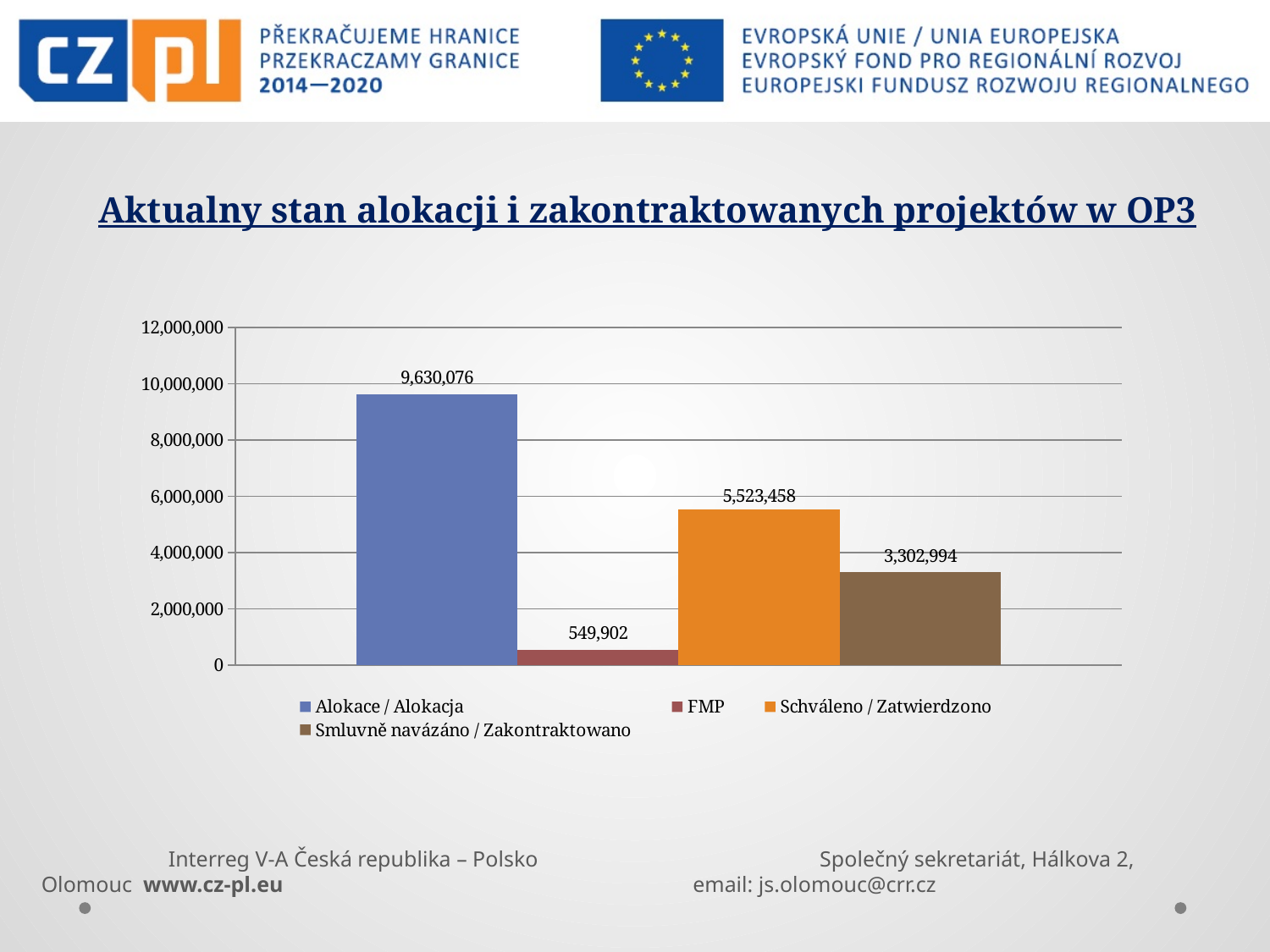
What is the value for Smluvně navázáno / Zakontraktowano? 3,302,994 What is the value for Alokace / Alokacja? 9,630,076 What is the difference between Alokace / Alokacja and Schváleno / Zatwierdzono? 4,106,618 Which is larger, Schváleno / Zatwierdzono or Smluvně navázáno / Zakontraktowano? Schváleno / Zatwierdzono What is the value for Schváleno / Zatwierdzono? 5,523,458 What kind of chart is shown on the slide? bar chart Which series has the lowest value? FMP What is the value for FMP? 549,902 Is the value for Alokace / Alokacja greater or less than 8,000,000? greater How many series does the legend list? 4 Which series has the highest value? Alokace / Alokacja What is the difference between Schváleno / Zatwierdzono and Smluvně navázáno / Zakontraktowano? 2,220,464